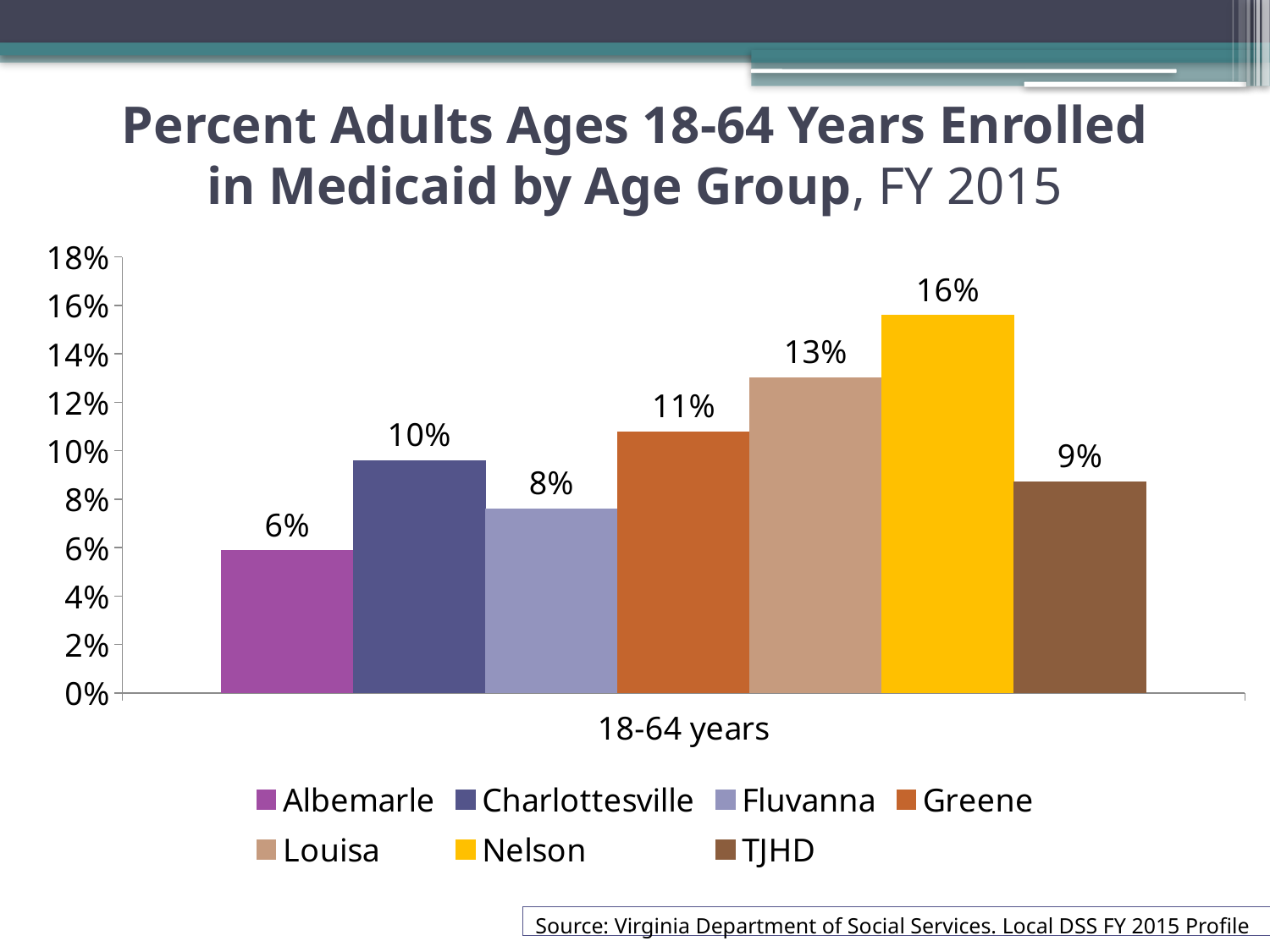
What is the value shown for Louisa? 13% How many series does the legend list? 7 What percent of adults ages 18-64 are enrolled in Medicaid in Albemarle? 6% Which locality has the highest percent of adults ages 18-64 enrolled in Medicaid? Nelson Is the value for Charlottesville greater or less than 12%? less Which is larger, the value for Greene or the value for Fluvanna? Greene What is the value shown for Nelson? 16% What kind of chart is shown on the slide? Bar chart What is the difference between the values for Nelson and Albemarle? 10% What colour is the bar for Nelson? Yellow What is the value shown for TJHD? 9% Which locality has the lowest percent of adults ages 18-64 enrolled in Medicaid? Albemarle